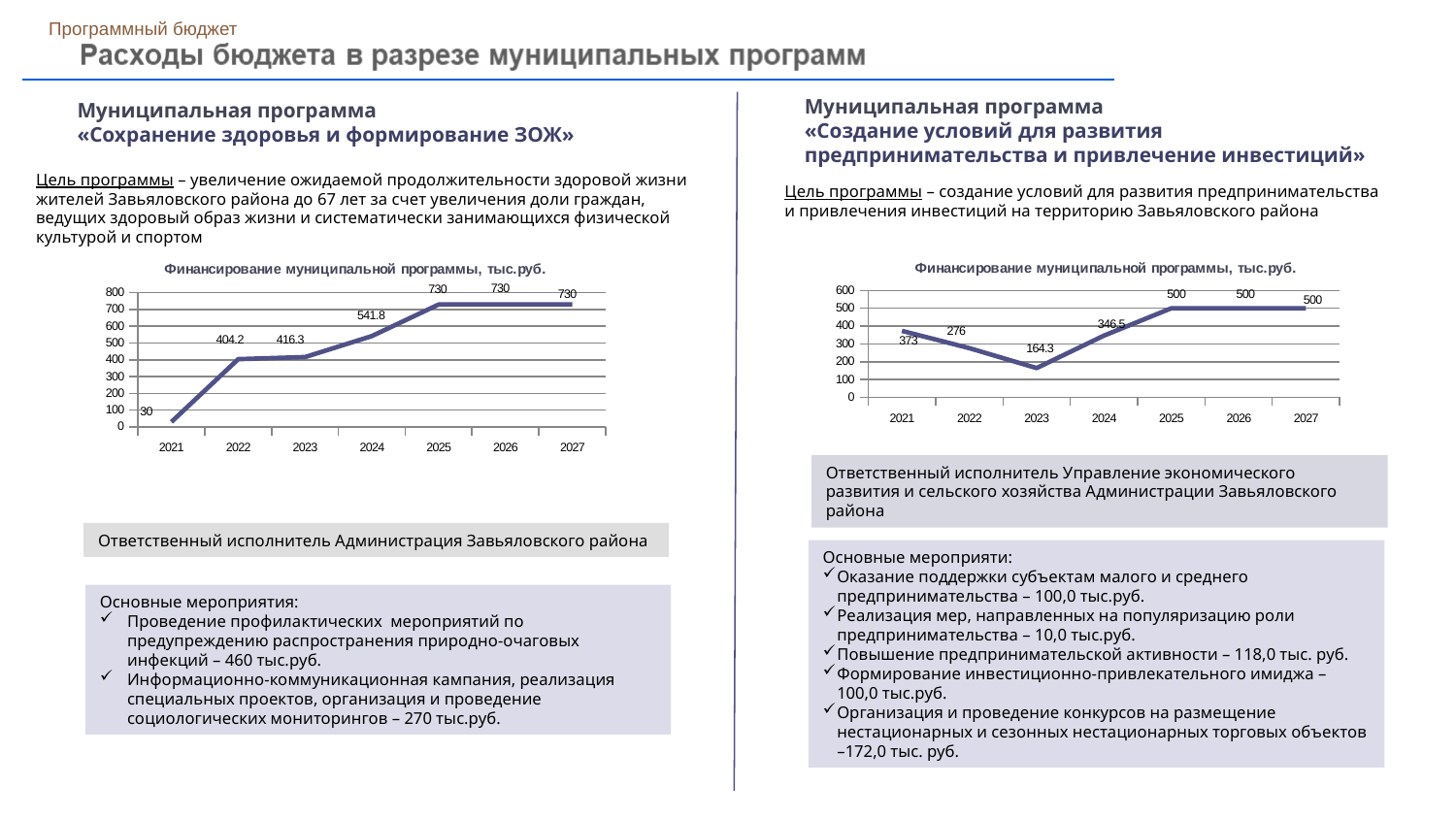
What type of chart is used on the left side of the slide? Line chart What is the title of the chart on the right side of the slide? Финансирование муниципальной программы, тыс.руб. In the right chart (Создание условий для развития предпринимательства), what is the funding value for 2023? 164.3 In the left chart (Сохранение здоровья и формирование ЗОЖ), which year has the lowest value? 2021 In the right chart (Создание условий для развития предпринимательства), what is the funding value for 2021? 373 In the left chart (Сохранение здоровья и формирование ЗОЖ), what is the funding value for 2024? 541.8 In the right chart (Создание условий для развития предпринимательства), which is larger: the value for 2021 or the value for 2024? 2021 In the left chart (Сохранение здоровья и формирование ЗОЖ), what is the difference between the 2023 and 2022 values? 12.1 In the left chart (Сохранение здоровья и формирование ЗОЖ), what is the funding value for 2021? 30 In the right chart (Создание условий для развития предпринимательства), which year has the lowest value? 2023 In the right chart (Создание условий для развития предпринимательства), what is the difference between the 2025 value and the 2024 value? 153.5 In the left chart (Сохранение здоровья и формирование ЗОЖ), how many years are plotted on the x axis? 7